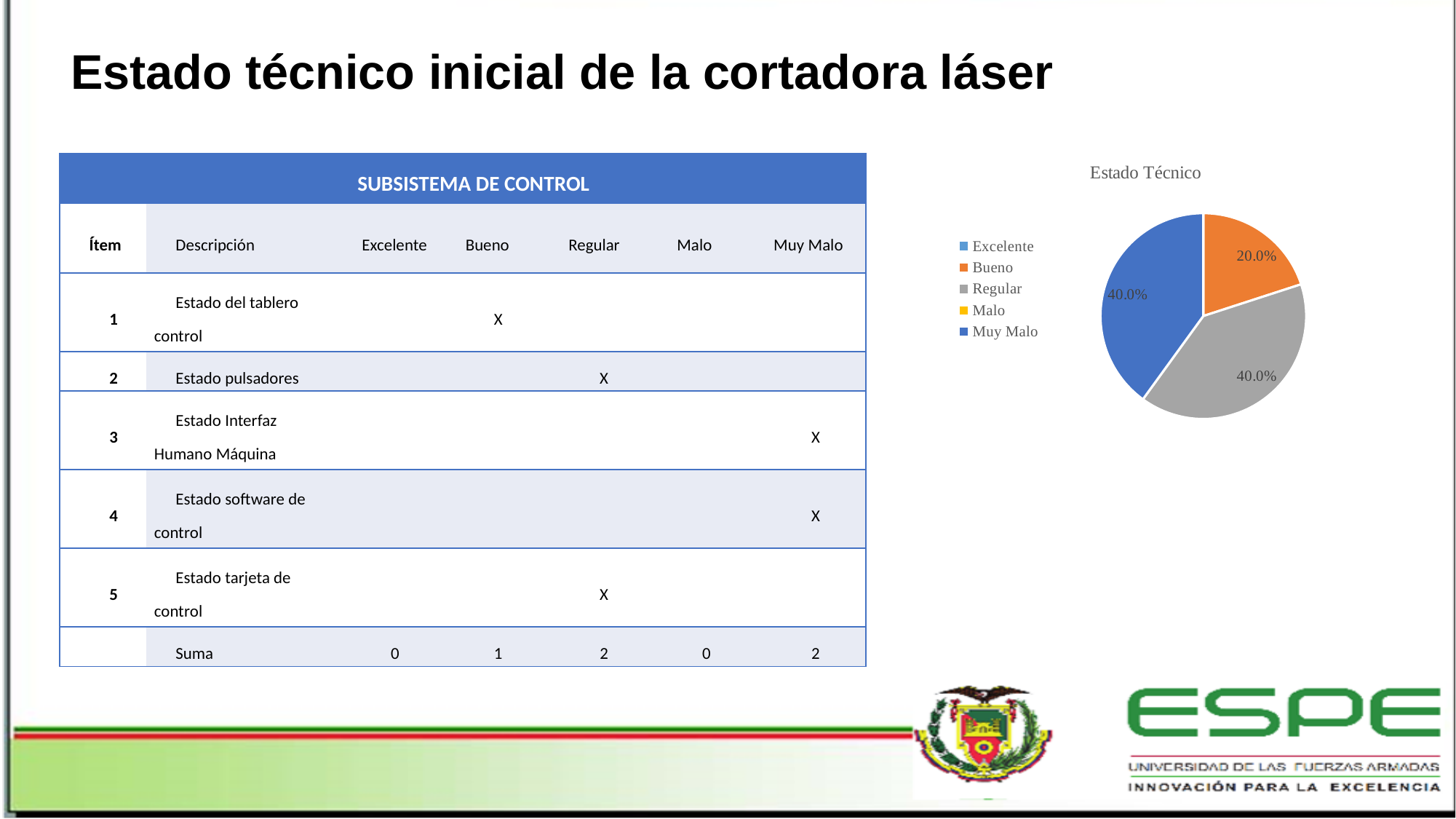
What colour is the Bueno slice in the pie chart? orange How many slices are visible in the pie chart? 3 What is the title of the chart? Estado Técnico Which is larger, the share for Muy Malo or the share for Bueno? Muy Malo Of the slices visible in the pie, which has the smallest share? Bueno What share of the pie does Muy Malo have? 40.0% What is the difference in percentage points between the Regular share and the Bueno share? 20.0 How many entries does the chart's legend list? 5 What kind of chart is shown on the slide? pie chart What share of the pie does Bueno have? 20.0% Which is larger, the share for Bueno or the share for Regular? Regular What share of the pie does Regular have? 40.0%